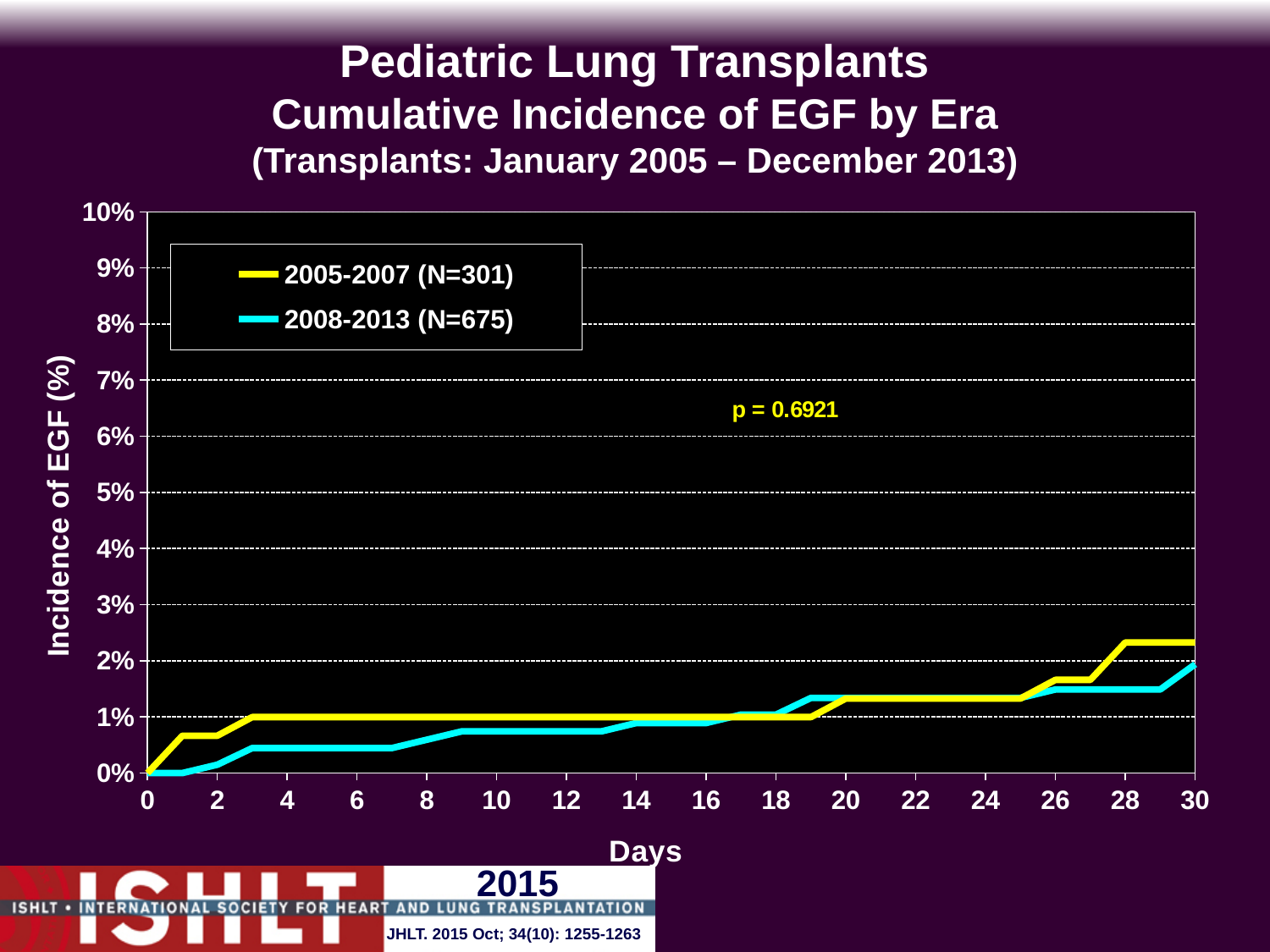
What are the two series named in the legend? 2005-2007 (N=301) and 2008-2013 (N=675) At day 30, which series has the higher cumulative incidence of EGF? 2005-2007 (N=301) What p-value is printed on the chart? p = 0.6921 What is the highest value shown on the y axis? 10% Is the value for the 2005-2007 series at day 30 greater or less than 2%? greater How many series does the legend list? 2 Do the values for the 2005-2007 series rise or fall as days increase from 0 to 30? rise What kind of chart is shown on the slide? line chart Is the value for the 2008-2013 series at day 10 greater or less than 1%? less At day 10, which series has the higher cumulative incidence of EGF? 2005-2007 (N=301) Is the value for the 2005-2007 series at day 1 greater or less than 1%? less